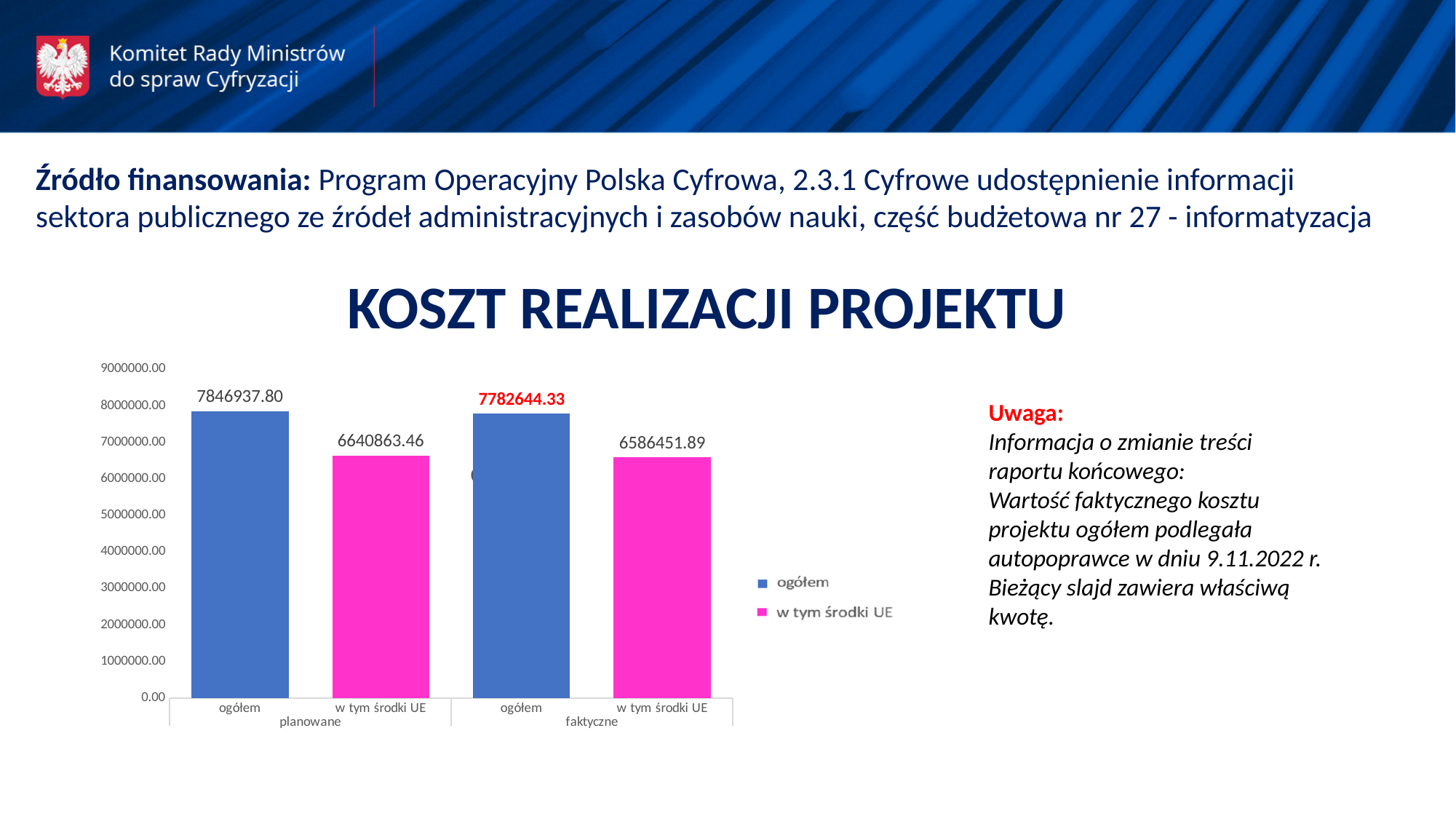
What is the difference between the planned and actual 'w tym środki UE' values? 54411.57 What is the planned (planowane) total cost (ogółem) shown on the chart? 7846937.80 What type of chart is shown on the slide? bar chart Which bar on the chart has the lowest value? faktyczne w tym środki UE How many series does the chart legend list? 2 What is the actual (faktyczne) total cost (ogółem) shown on the chart? 7782644.33 Which bar on the chart has the highest value? planowane ogółem How many bars are plotted on the chart? 4 What is the planned (planowane) value for 'w tym środki UE'? 6640863.46 What is the actual (faktyczne) value for 'w tym środki UE'? 6586451.89 What is the difference between the planned and actual total cost (ogółem)? 64293.47 Which is larger: the planned total cost (ogółem) or the actual total cost (ogółem)? planned (planowane) ogółem